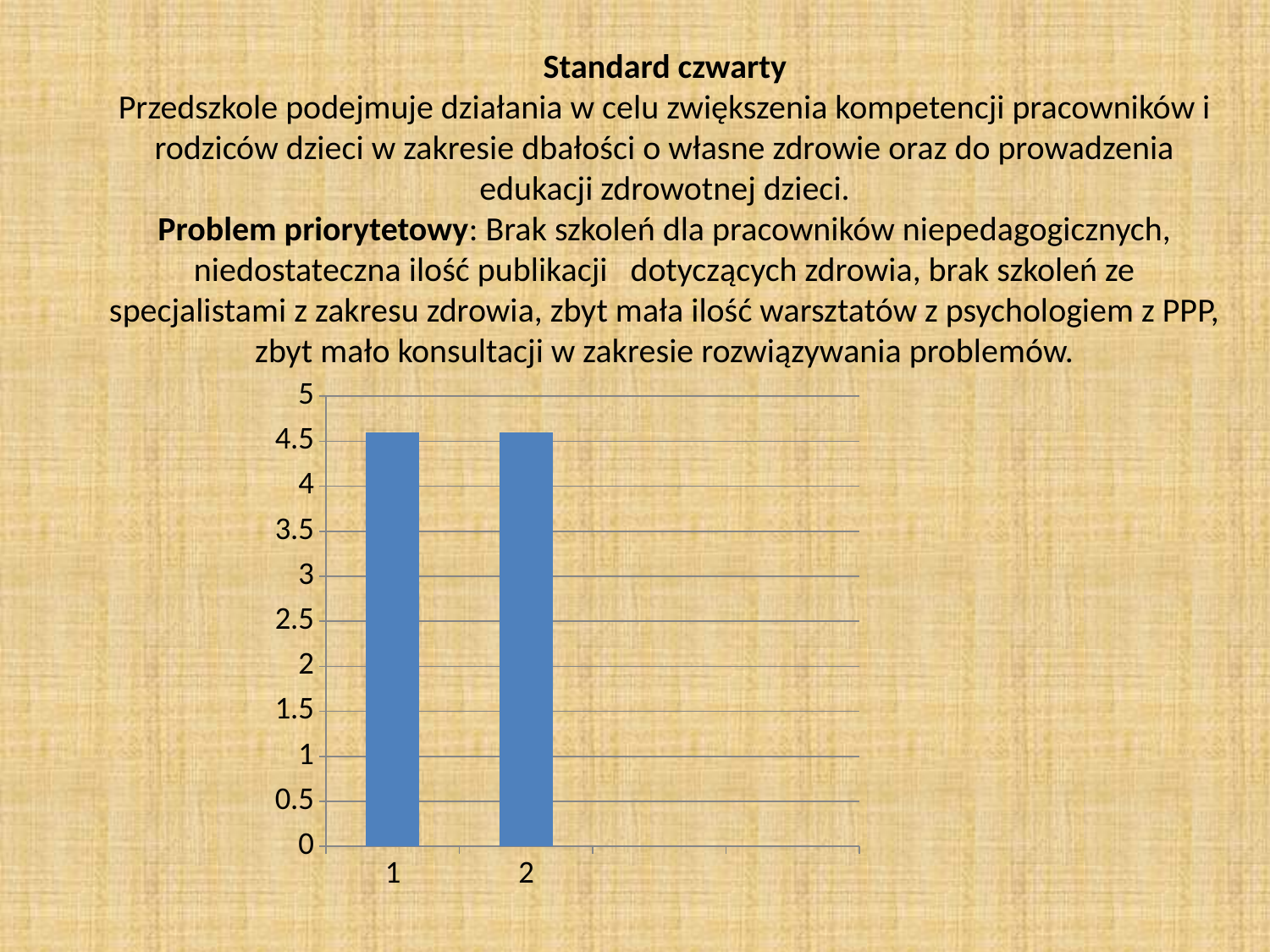
How many bars does the chart show? 2 Is the value for category 2 greater or less than 4? greater What is the highest value shown on the y axis of the chart? 5 What kind of chart is shown on the slide? bar chart Is the value for category 2 greater or less than 3? greater Is the value for category 1 greater or less than 5? less What are the category labels on the x axis of the chart? 1 and 2